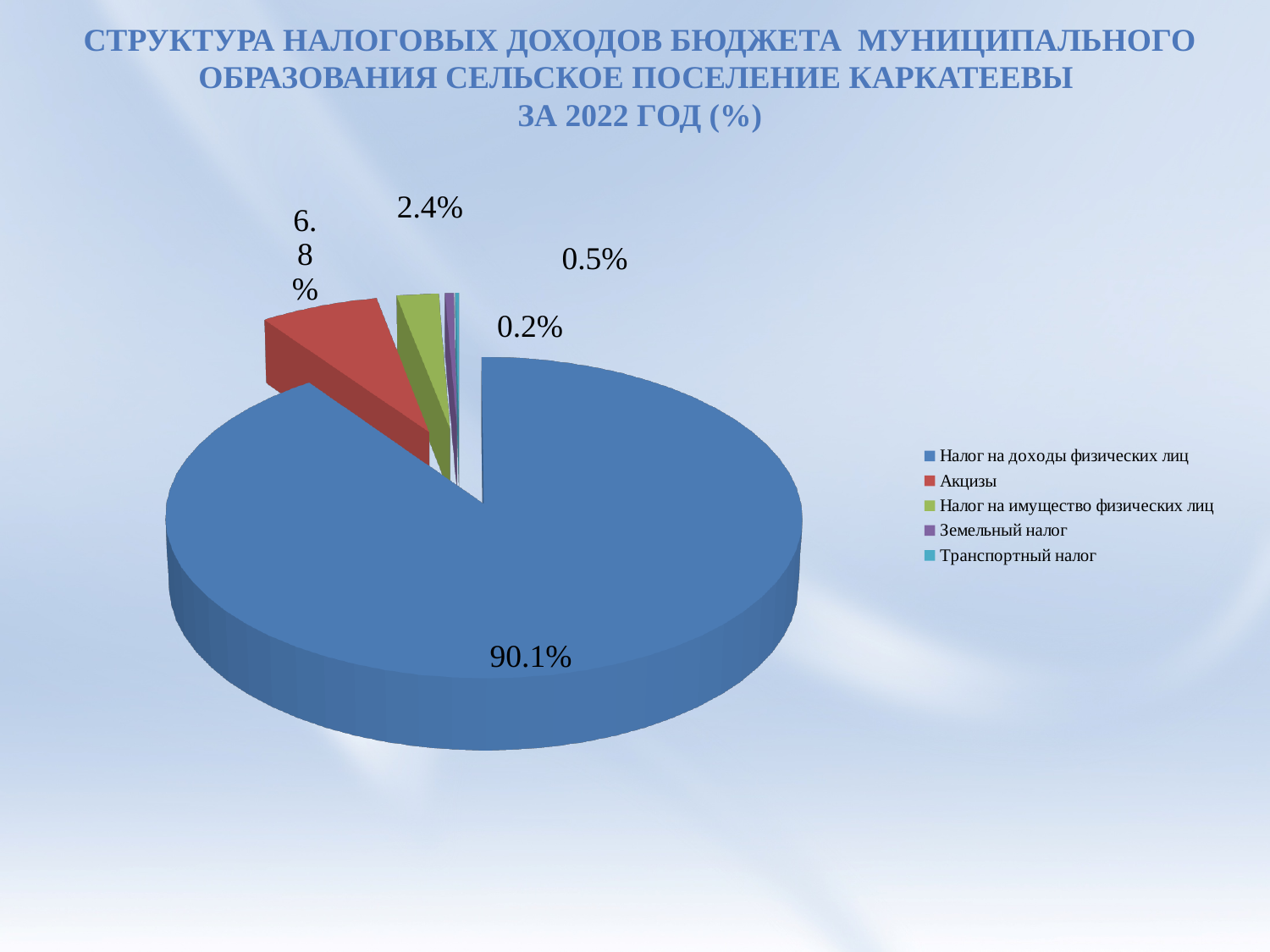
What is the value shown for Акцизы? 6.8% Which is larger, Акцизы or Налог на имущество физических лиц? Акцизы What share of tax revenue does Налог на доходы физических лиц account for? 90.1% How many categories does the legend list? 5 Which category has the smallest slice of the pie? Транспортный налог Which year does the chart title refer to? 2022 Which category has the largest slice of the pie? Налог на доходы физических лиц What is the value shown for Налог на имущество физических лиц? 2.4% What is the difference between the shares of Налог на доходы физических лиц and Акцизы? 83.3% What colour is the slice for Акцизы? red What kind of chart is shown on the slide? pie chart What is the difference between the shares of Акцизы and Налог на имущество физических лиц? 4.4%